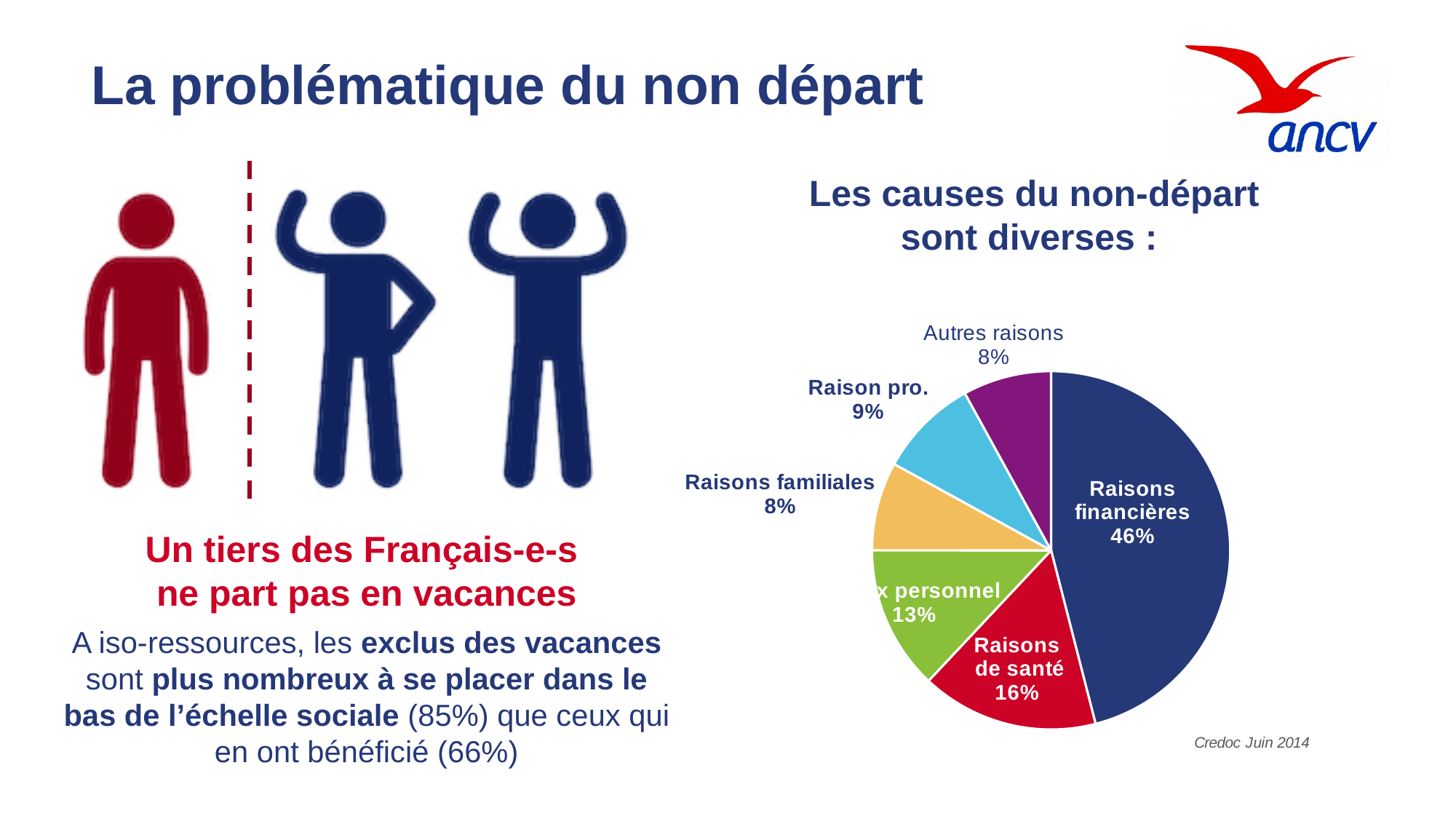
What percentage is shown for 'Raisons familiales'? 8% What type of chart is shown on the slide? Pie chart What is the combined share of 'Raisons financières' and 'Raisons de santé'? 62% Which category has the largest slice of the pie chart? Raisons financières How many slices does the pie chart have? 6 What is the value for 'Autres raisons' in the pie chart? 8% What source is cited below the pie chart? Credoc Juin 2014 What share does 'Raisons de santé' have in the pie chart? 16% Which is larger in the pie chart: 'Raison pro.' or 'Raisons familiales'? Raison pro. What percentage of the pie chart is attributed to 'Raisons financières'? 46% How many percentage points larger is 'Raisons financières' than 'Raisons de santé'? 30 What is the value shown for 'Raison pro.' in the pie chart? 9%